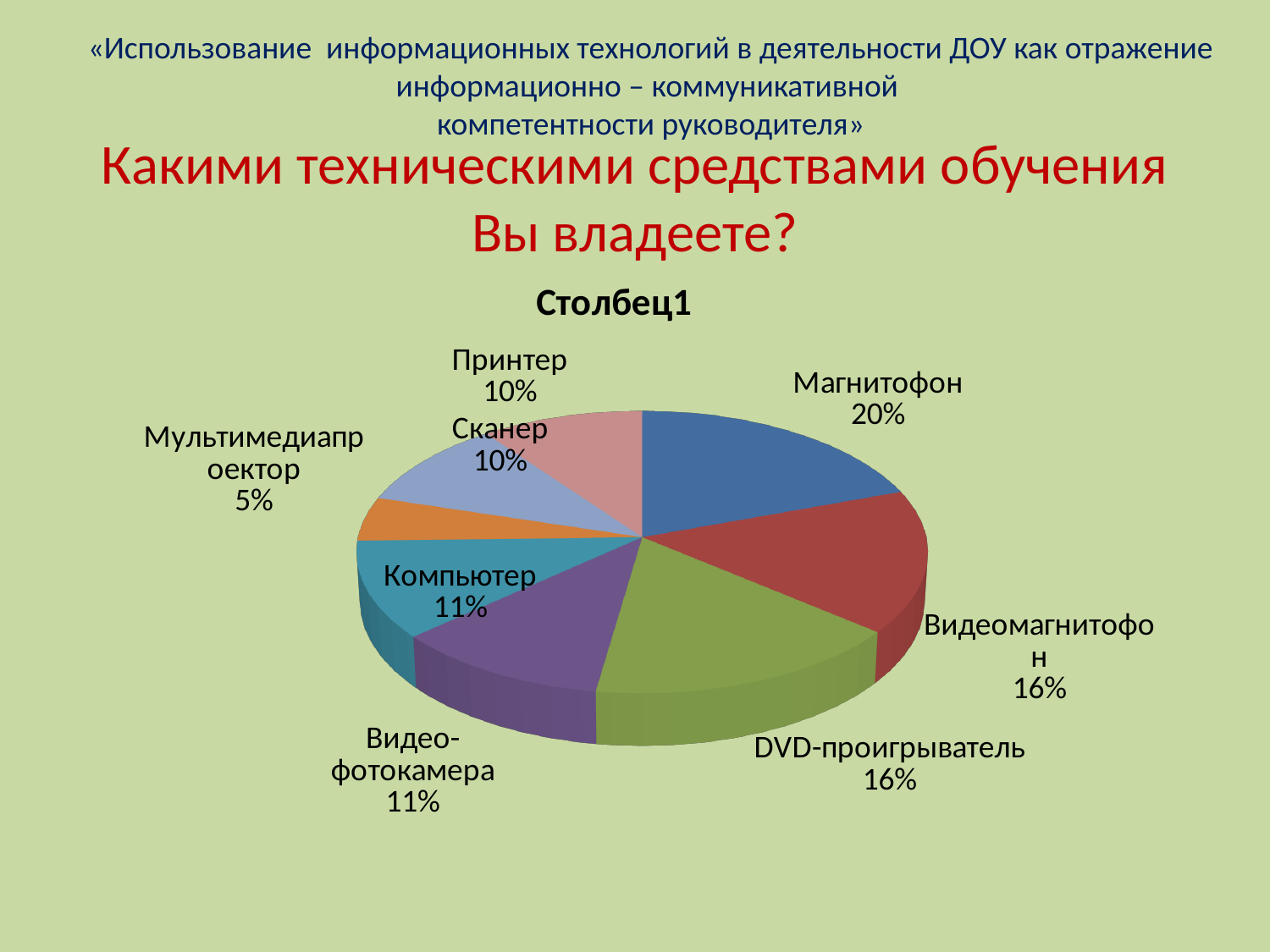
What share of the pie is Магнитофон? 20% Which category has the largest share of the pie? Магнитофон Which category has the smallest share of the pie? Мультимедиапроектор What is the value shown for Компьютер? 11% What is the value shown for Видеомагнитофон? 16% How many slices does the pie chart have? 8 What is the difference between the shares of Магнитофон and Сканер? 10% What kind of chart is shown on the slide? pie chart Which is larger, the share for DVD-проигрыватель or the share for Принтер? DVD-проигрыватель What is the value shown for Мультимедиапроектор? 5% What is the chart's title? Столбец1 What is the difference between the shares of Видео-фотокамера and Мультимедиапроектор? 6%